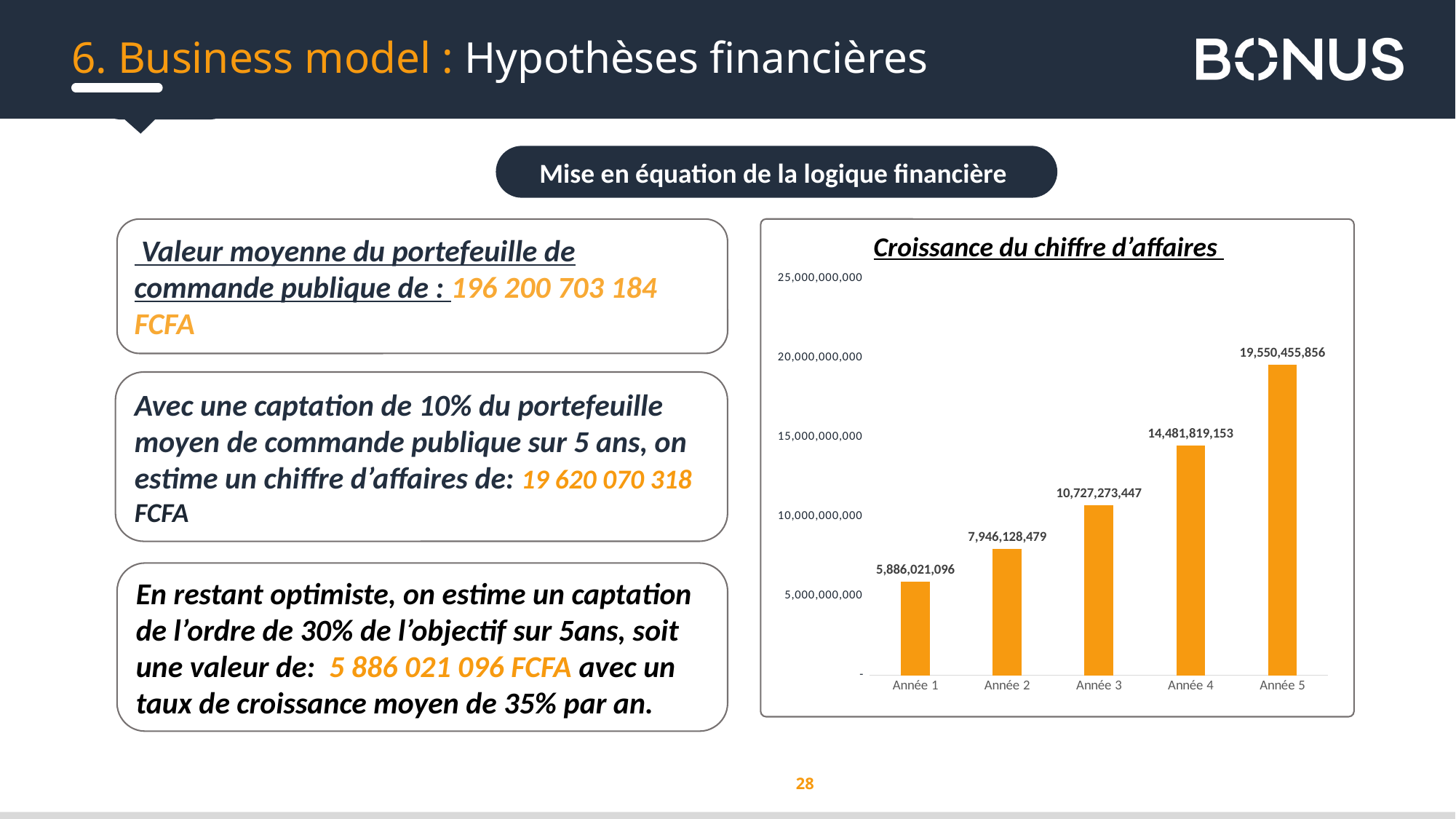
How many years are shown on the x axis of the chart? 5 Which year has the lowest value in the chart? Année 1 What is the value for Année 3 in the chart? 10,727,273,447 What is the difference between the values for Année 2 and Année 1? 2,060,107,383 Which year has the highest value in the chart? Année 5 What is the difference between the values for Année 5 and Année 4? 5,068,636,703 Is the value for Année 3 greater or less than 10,000,000,000? greater Which is larger, the value for Année 2 or the value for Année 4? Année 4 What is the value for Année 5 in the chart? 19,550,455,856 What kind of chart is shown on the slide? bar chart Do the values rise or fall from Année 1 to Année 5? rise What is the value for Année 1 in the chart? 5,886,021,096